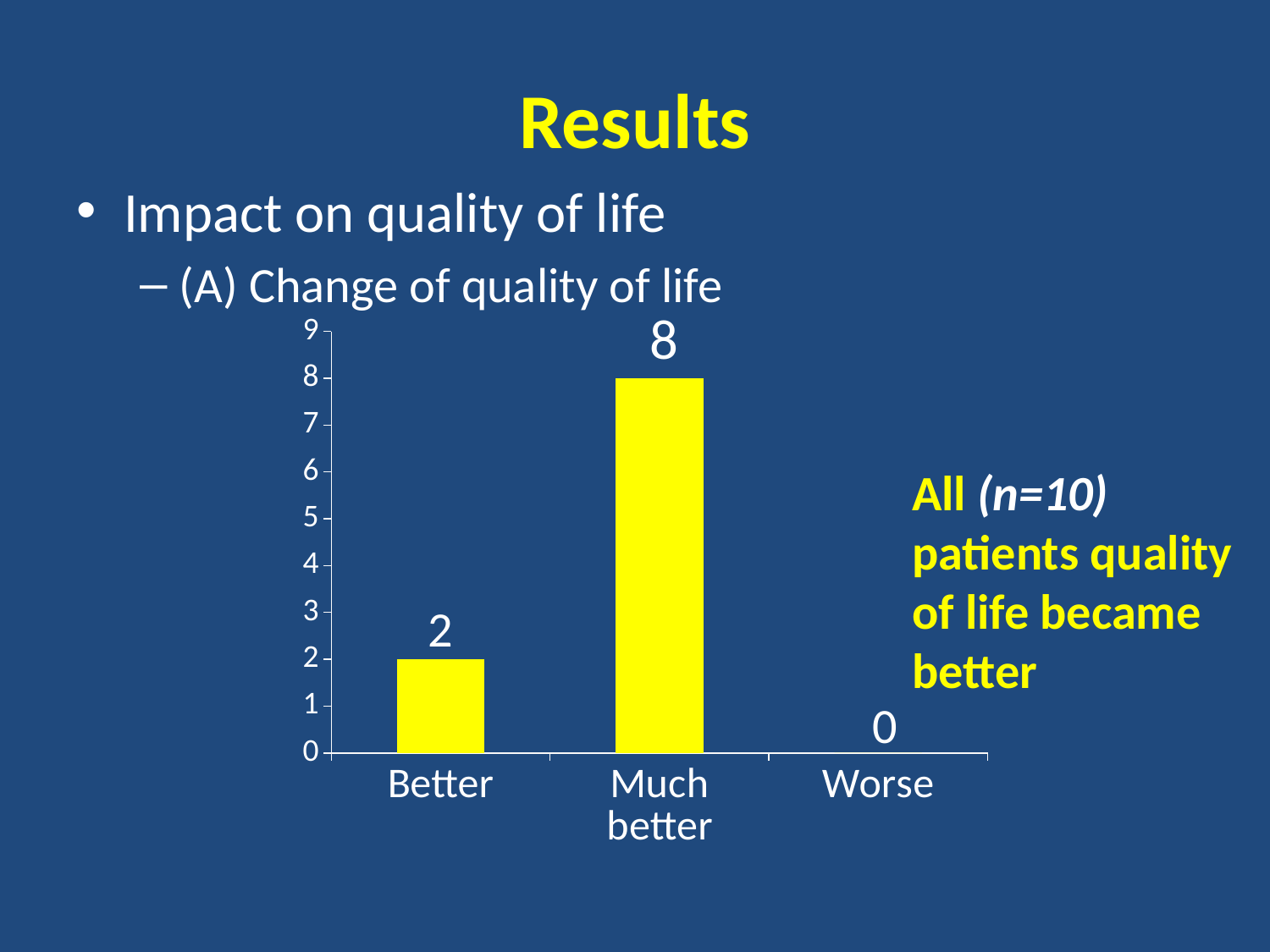
What is the value for Worse? 0 How many categories are shown on the x axis? 3 What is the total of the values for Better, Much better and Worse? 10 What is the difference between the values for Much better and Better? 6 What colour are the bars in the chart? yellow Which category has the lowest value? Worse Which is larger, the value for Better or the value for Much better? Much better What kind of chart is shown on the slide? bar chart What is the value for Better? 2 Which category has the highest value? Much better What is the value for Much better? 8 Is the value for Much better greater or less than 5? greater